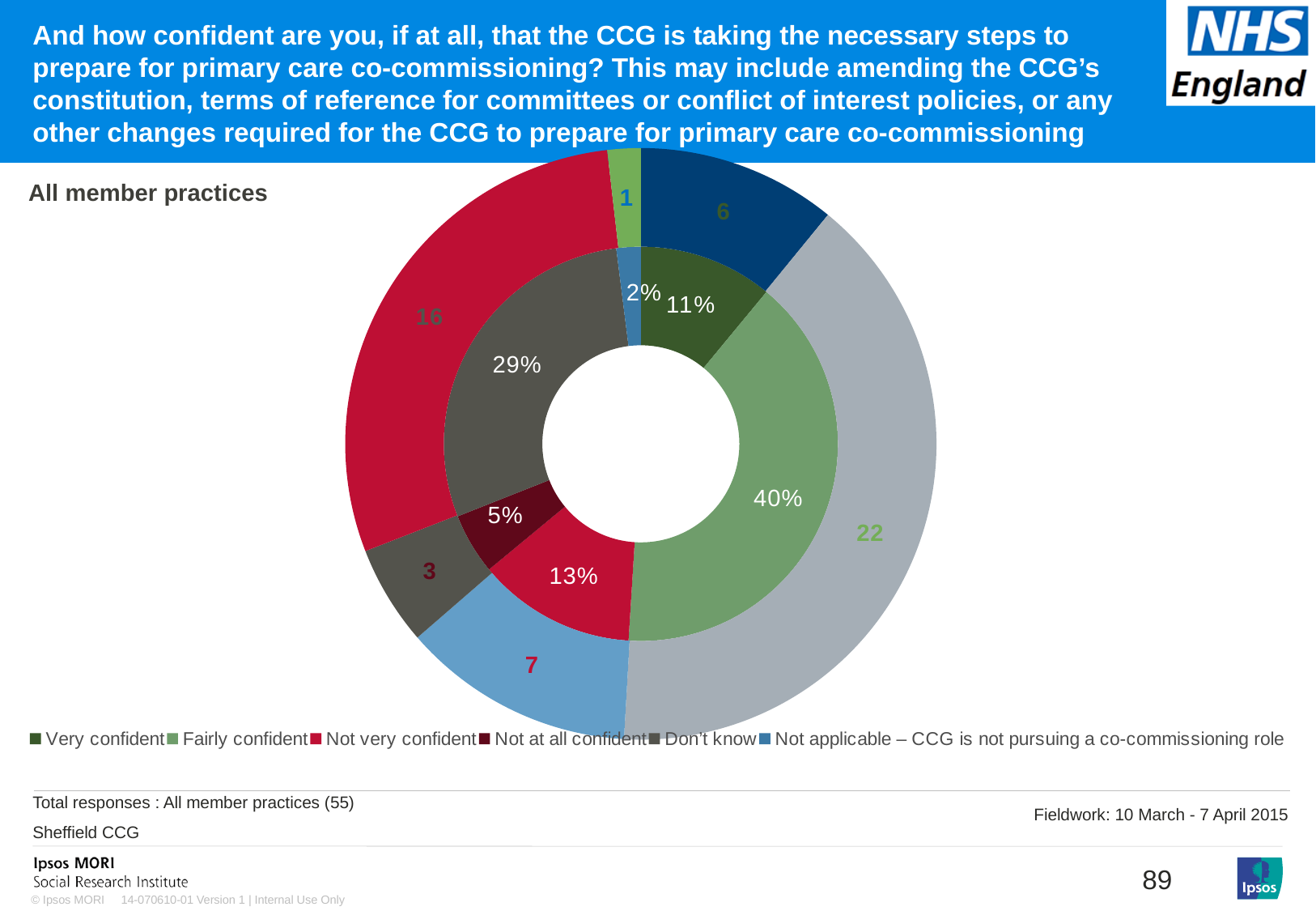
What type of chart is shown on the slide? Doughnut chart What is the largest value shown in the outer ring of the chart? 22 What percentage of respondents answered 'Don't know' in the inner ring? 29% Which is larger in the inner ring: 'Very confident' or 'Not very confident'? Not very confident How many categories does the legend list? 6 What is the difference in percentage points between 'Fairly confident' and 'Don't know' in the inner ring? 11 What percentage of respondents are 'Not at all confident' in the inner ring? 5% Which category has the smallest share in the inner ring? Not applicable – CCG is not pursuing a co-commissioning role What percentage of respondents are 'Not very confident' in the inner ring? 13% What percentage of respondents are 'Fairly confident' in the inner ring? 40% What percentage of respondents are 'Very confident' in the inner ring? 11% Which category has the largest share in the inner ring? Fairly confident